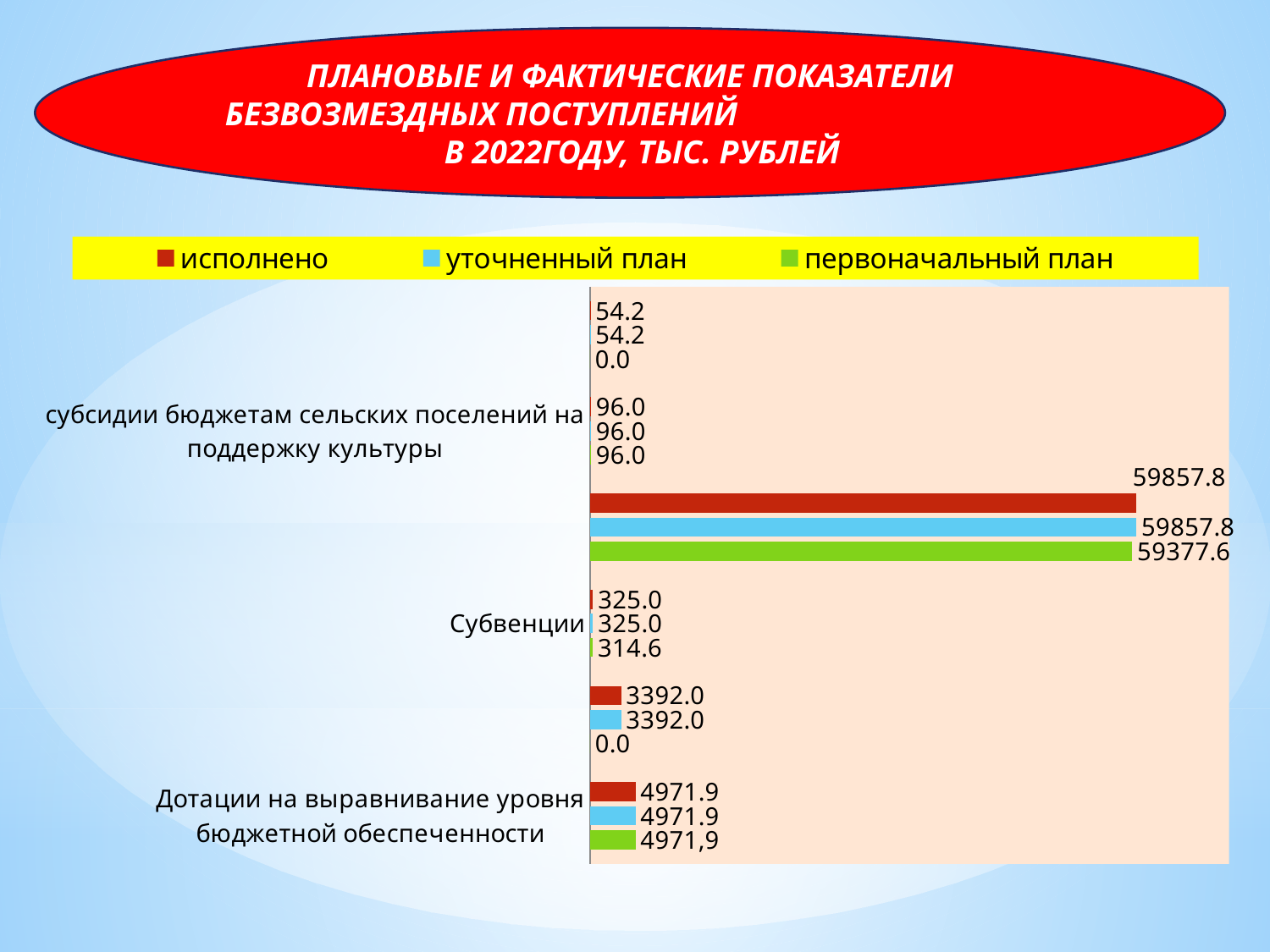
What is the value of 'уточненный план' for 'субсидии бюджетам сельских поселений на поддержку культуры'? 96.0 What is the value of 'первоначальный план' for 'Субвенции'? 314.6 What colour represents the 'исполнено' series in the legend? red What is the difference between the 'исполнено' values for 'Дотации на выравнивание уровня бюджетной обеспеченности' and 'Субвенции'? 4646.9 What is the value of 'первоначальный план' for 'Дотации на выравнивание уровня бюджетной обеспеченности', as printed on the slide? 4971,9 What year do the indicators in the slide title refer to? 2022 What kind of chart is shown on the slide? bar chart What is the value of 'исполнено' for 'Субвенции'? 325.0 How many series does the legend list? 3 What is the value of 'исполнено' for 'Дотации на выравнивание уровня бюджетной обеспеченности'? 4971.9 What is the difference between 'уточненный план' and 'первоначальный план' for 'Субвенции'? 10.4 Which has the larger 'исполнено' value: 'Субвенции' or 'Дотации на выравнивание уровня бюджетной обеспеченности'? Дотации на выравнивание уровня бюджетной обеспеченности